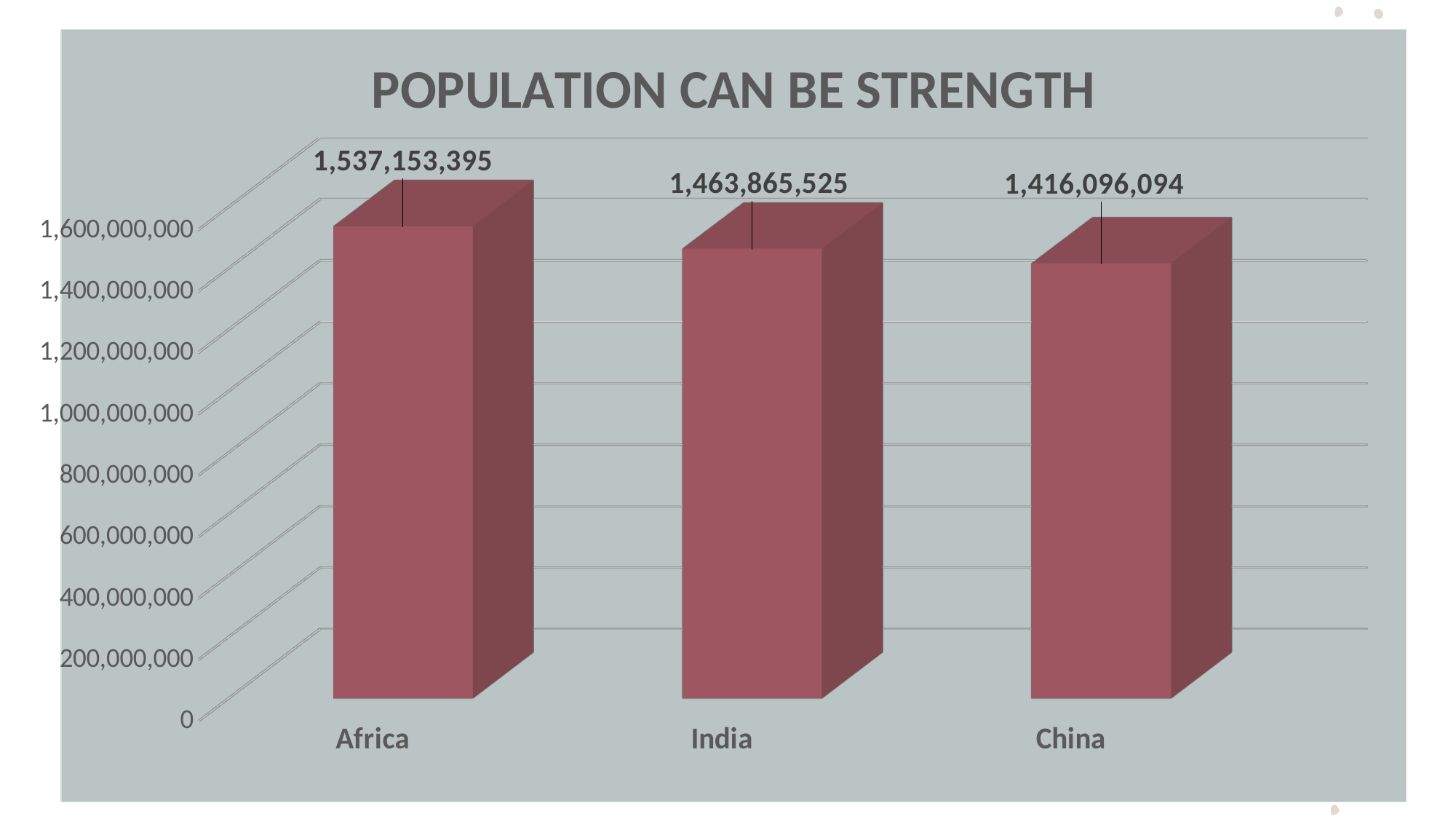
What is the difference between the values for India and China? 47,769,431 What is the value shown for India? 1,463,865,525 What is the value shown for China? 1,416,096,094 What is the value shown for Africa? 1,537,153,395 How many categories are shown on the chart? 3 What is the title of the chart? POPULATION CAN BE STRENGTH Which category has the highest value? Africa What is the difference between the values for Africa and India? 73,287,870 Is the value for China greater or less than 1,400,000,000? greater Which is larger, the value for India or the value for China? India Which category has the lowest value? China What kind of chart is shown on the slide? Bar chart